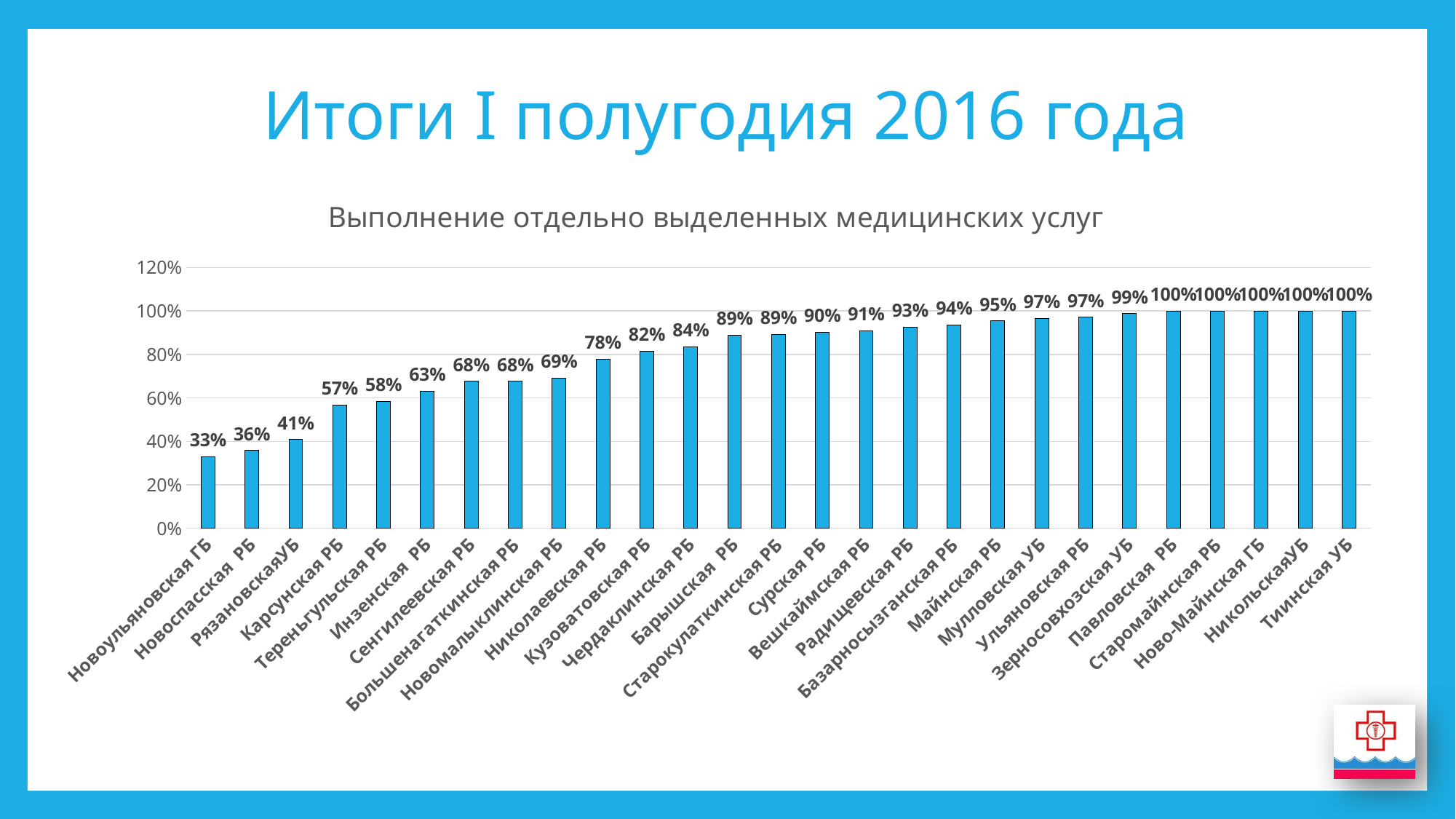
Do the values rise or fall from left to right along the x axis? rise How many categories are shown in the chart? 27 What is the value for Зерносовхозская УБ? 99% What is the difference between the values for Николаевская РБ and Новоспасская РБ? 42% Which category has the lowest value? Новоульяновская ГБ What is the value for Чердаклинская РБ? 84% Which has a larger value, Инзенская РБ or Сурская РБ? Сурская РБ How many categories have a value of 100%? 5 What is the title of the chart? Выполнение отдельно выделенных медицинских услуг What is the value for Карсунская РБ? 57% What is the highest value shown in the chart? 100% What type of chart is shown on the slide? bar chart